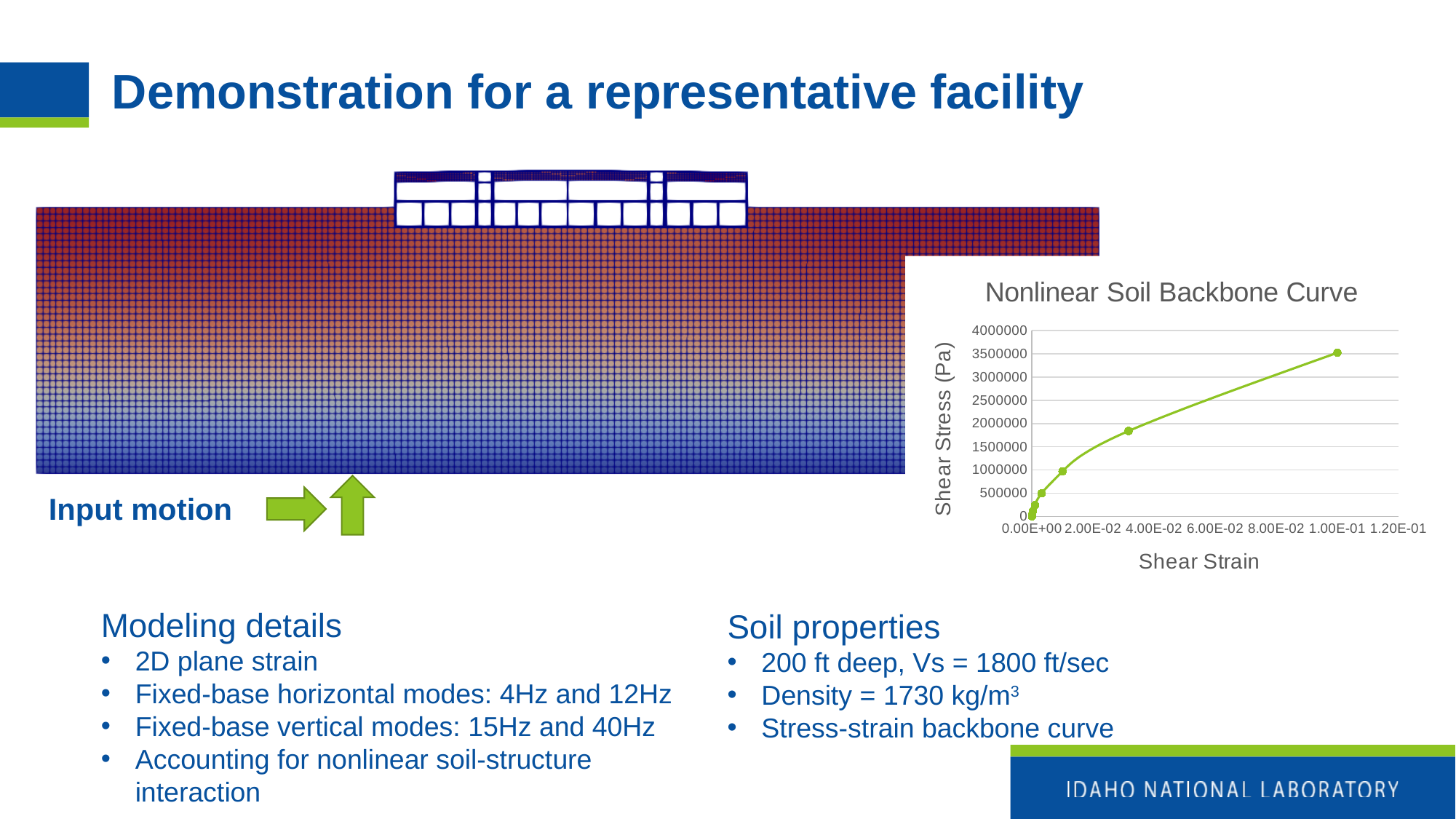
What is the highest value shown on the x axis of the Nonlinear Soil Backbone Curve chart? 1.20E-01 What is the y-axis label of the Nonlinear Soil Backbone Curve chart? Shear Stress (Pa) In the Nonlinear Soil Backbone Curve chart, is the shear stress at a shear strain of 1.00E-01 greater or less than 3000000? greater What is the title of the chart on the slide? Nonlinear Soil Backbone Curve What kind of chart is the Nonlinear Soil Backbone Curve? Line chart In the Nonlinear Soil Backbone Curve chart, does shear stress rise or fall as shear strain increases? Rises In the Nonlinear Soil Backbone Curve chart, is the shear stress at a shear strain of 2.00E-02 greater or less than 2000000? less In the Nonlinear Soil Backbone Curve chart, is the shear stress at a shear strain of 2.00E-02 greater or less than 1000000? greater In the Nonlinear Soil Backbone Curve chart, at which shear strain value does the curve reach its highest shear stress? 1.00E-01 What is the highest value shown on the y axis of the Nonlinear Soil Backbone Curve chart? 4000000 In the Nonlinear Soil Backbone Curve chart, which has the larger shear stress: the point at shear strain 1.00E-01 or the point near shear strain 4.00E-02? The point at 1.00E-01